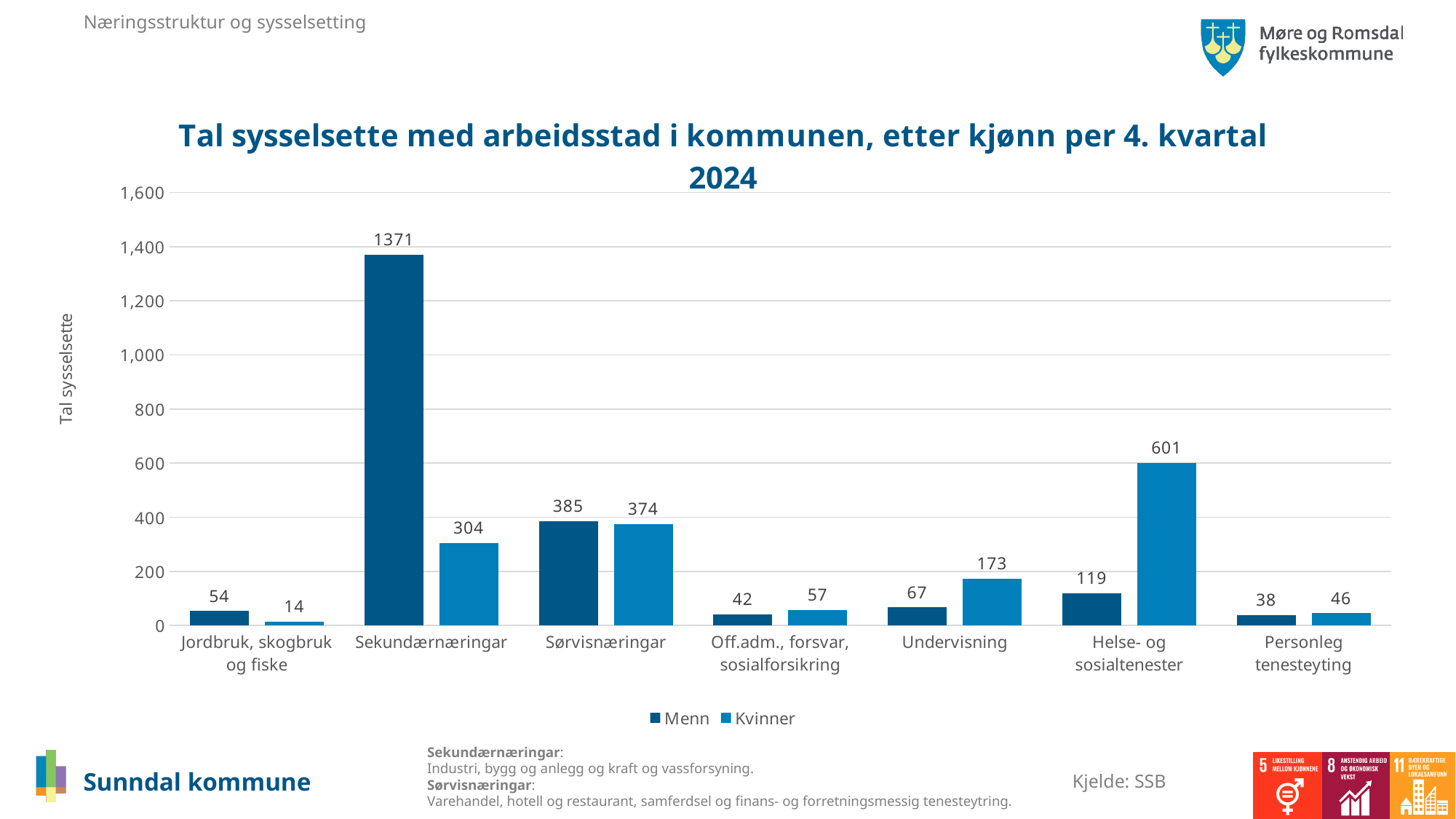
How many series does the legend list? 2 What is the label of the y axis? Tal sysselsette Which category has the highest value for Menn? Sekundærnæringar Which category has the lowest value for Kvinner? Jordbruk, skogbruk og fiske What kind of chart is shown on the slide? Bar chart What is the value for Kvinner in Helse- og sosialtenester? 601 What is the value for Menn in Sekundærnæringar? 1371 What is the difference between Menn and Kvinner in Sekundærnæringar? 1067 How many categories are shown on the x axis? 7 What is the value for Kvinner in Jordbruk, skogbruk og fiske? 14 What is the difference between Kvinner and Menn in Helse- og sosialtenester? 482 Which is larger in Undervisning, Menn or Kvinner? Kvinner